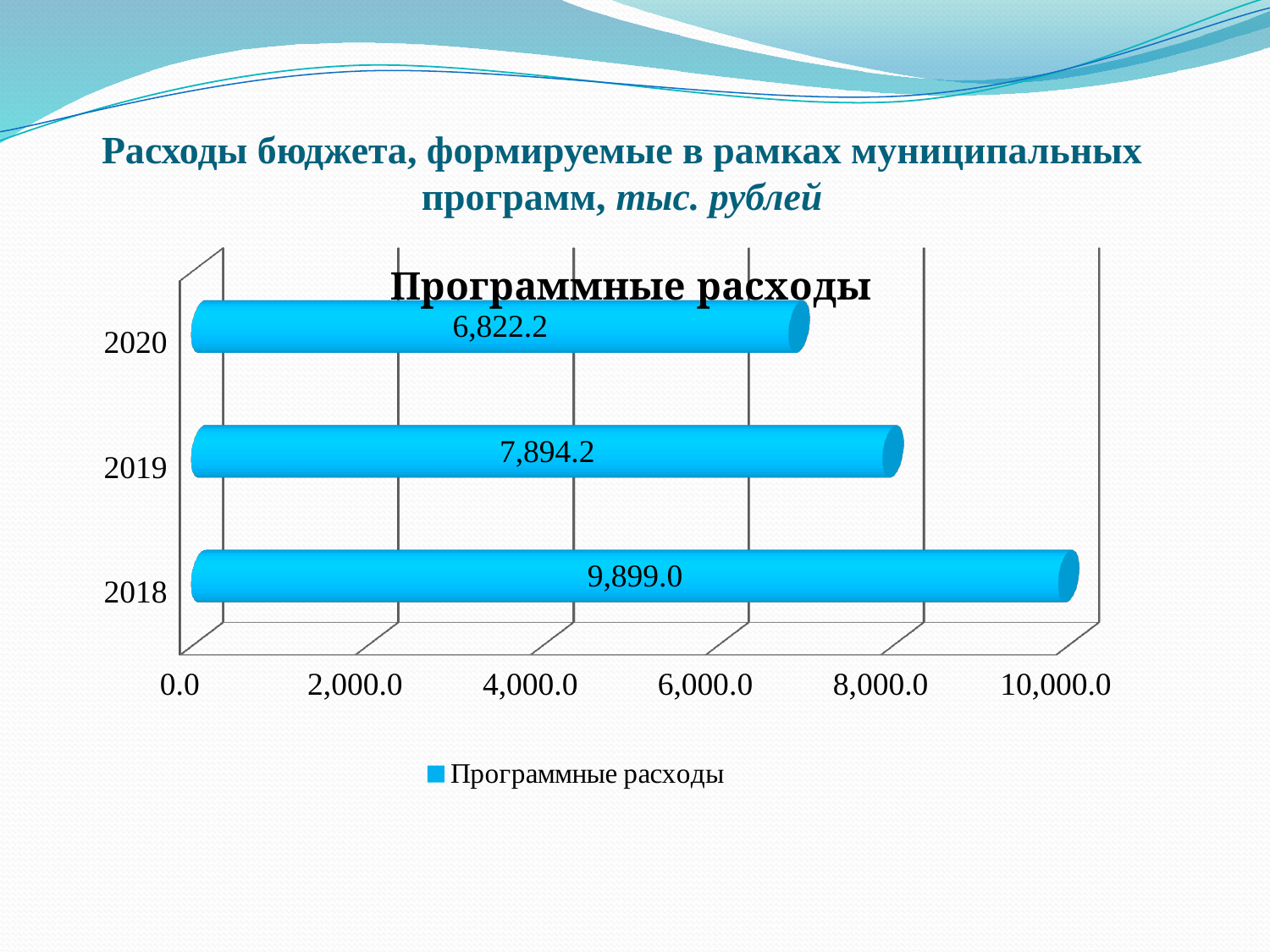
What is the title of the chart? Программные расходы How many years are shown in the chart? 3 What is the value for 2020? 6,822.2 What is the value for 2018? 9,899.0 What is the difference between the values for 2019 and 2020? 1,072.0 What kind of chart is this? bar chart Which is larger, the value for 2019 or the value for 2020? 2019 What is the value for 2019? 7,894.2 What is the difference between the values for 2018 and 2020? 3,076.8 Which year has the lowest value? 2020 Is the value for 2019 greater or less than 8,000.0? less Which year has the highest value? 2018